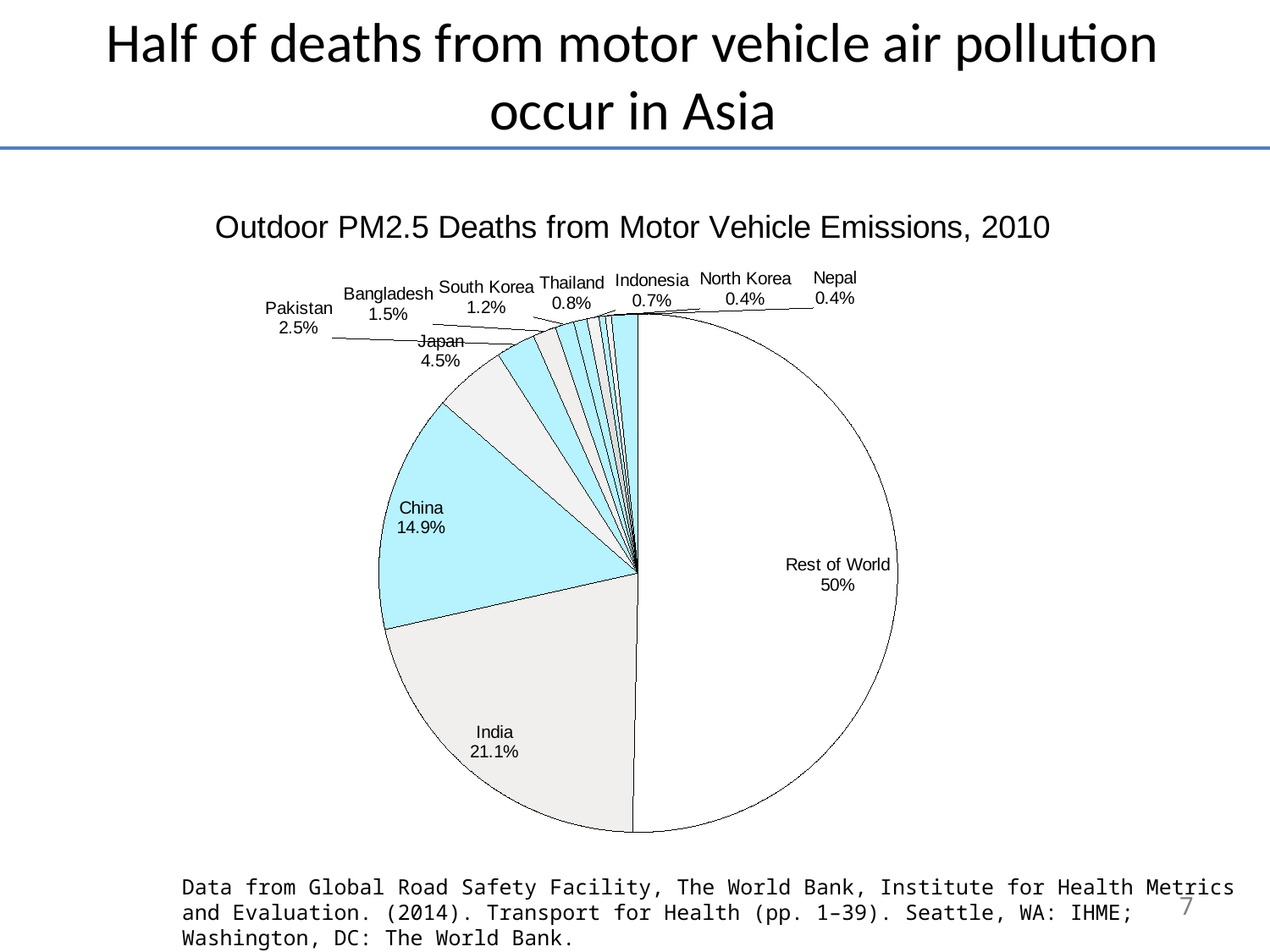
What percentage is shown for Japan? 4.5% Which is larger, the share for Bangladesh or the share for South Korea? Bangladesh What share of the pie does India account for? 21.1% What is the title of the chart? Outdoor PM2.5 Deaths from Motor Vehicle Emissions, 2010 What share of the pie does China account for? 14.9% What percentage is shown for Pakistan? 2.5% What kind of chart is shown on the slide? Pie chart What is the difference in percentage points between India and China? 6.2 How many slices does the pie chart have? 12 Which slice of the pie is the largest? Rest of World What is the combined share of India and China? 36% Which country has the largest share among the named Asian countries? India